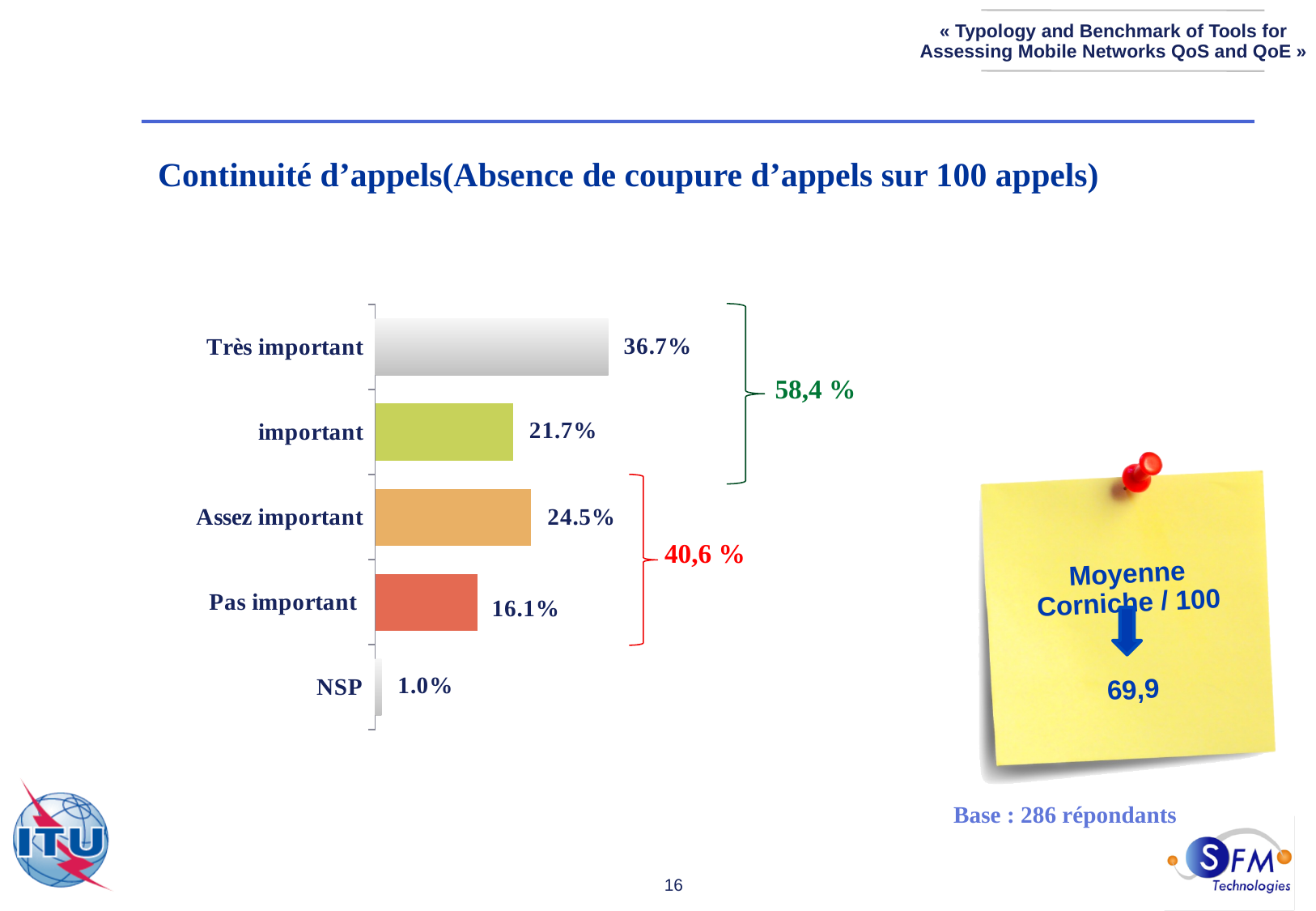
What is the value for "NSP"? 1.0% How many categories are shown in the chart? 5 What is the combined share shown by the green bracket for "Très important" and "important"? 58,4 % What is the value for "Assez important"? 24.5% What is the difference between "Assez important" and "Pas important"? 8.4% What is the difference between "Très important" and "important"? 15.0% What kind of chart is shown on the slide? Bar chart Which category has the highest value? Très important What is the value for "Très important"? 36.7% Which category has the lowest value? NSP What is the combined share shown by the red bracket for "Assez important" and "Pas important"? 40,6 % Which is larger, "Assez important" or "Pas important"? Assez important